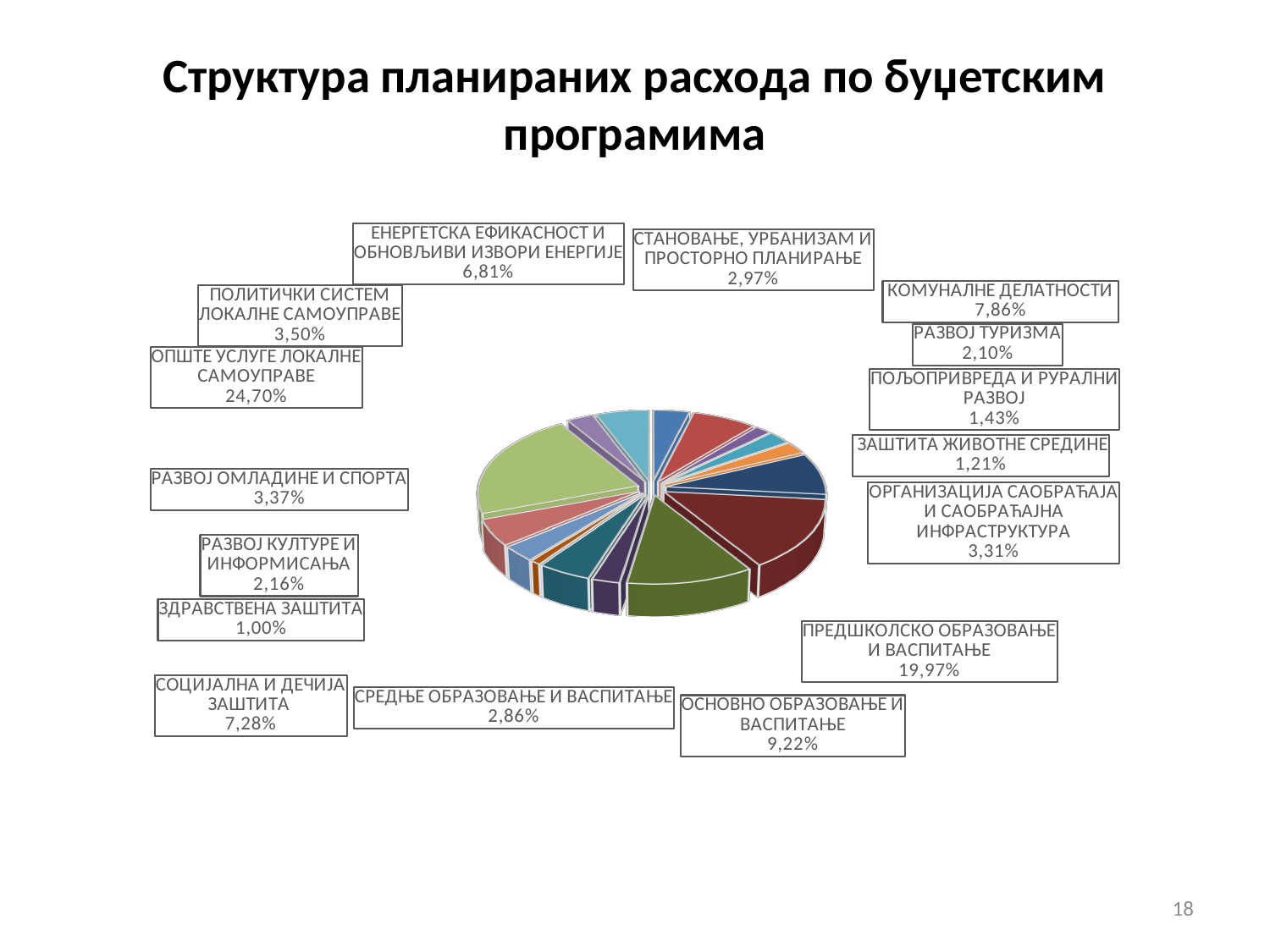
What is the difference between the shares of ОСНОВНО ОБРАЗОВАЊЕ И ВАСПИТАЊЕ and КОМУНАЛНЕ ДЕЛАТНОСТИ? 1,36% What is the title of the chart on the slide? Структура планираних расхода по буџетским програмима How many categories (slices) does the pie chart have? 16 What share does ПРЕДШКОЛСКО ОБРАЗОВАЊЕ И ВАСПИТАЊЕ have in the pie chart? 19,97% Which category has the smallest share of the pie chart? ЗДРАВСТВЕНА ЗАШТИТА What is the difference in percentage points between ОПШТЕ УСЛУГЕ ЛОКАЛНЕ САМОУПРАВЕ and ПРЕДШКОЛСКО ОБРАЗОВАЊЕ И ВАСПИТАЊЕ? 4,73% Which category has the largest share of the pie chart? ОПШТЕ УСЛУГЕ ЛОКАЛНЕ САМОУПРАВЕ What is the value shown for КОМУНАЛНЕ ДЕЛАТНОСТИ? 7,86% What kind of chart is shown on the slide? pie chart What share does ОПШТЕ УСЛУГЕ ЛОКАЛНЕ САМОУПРАВЕ have in the pie chart? 24,70% What is the value shown for ЗАШТИТА ЖИВОТНЕ СРЕДИНЕ? 1,21% Which has a larger share, ОСНОВНО ОБРАЗОВАЊЕ И ВАСПИТАЊЕ or СОЦИЈАЛНА И ДЕЧИЈА ЗАШТИТА? ОСНОВНО ОБРАЗОВАЊЕ И ВАСПИТАЊЕ